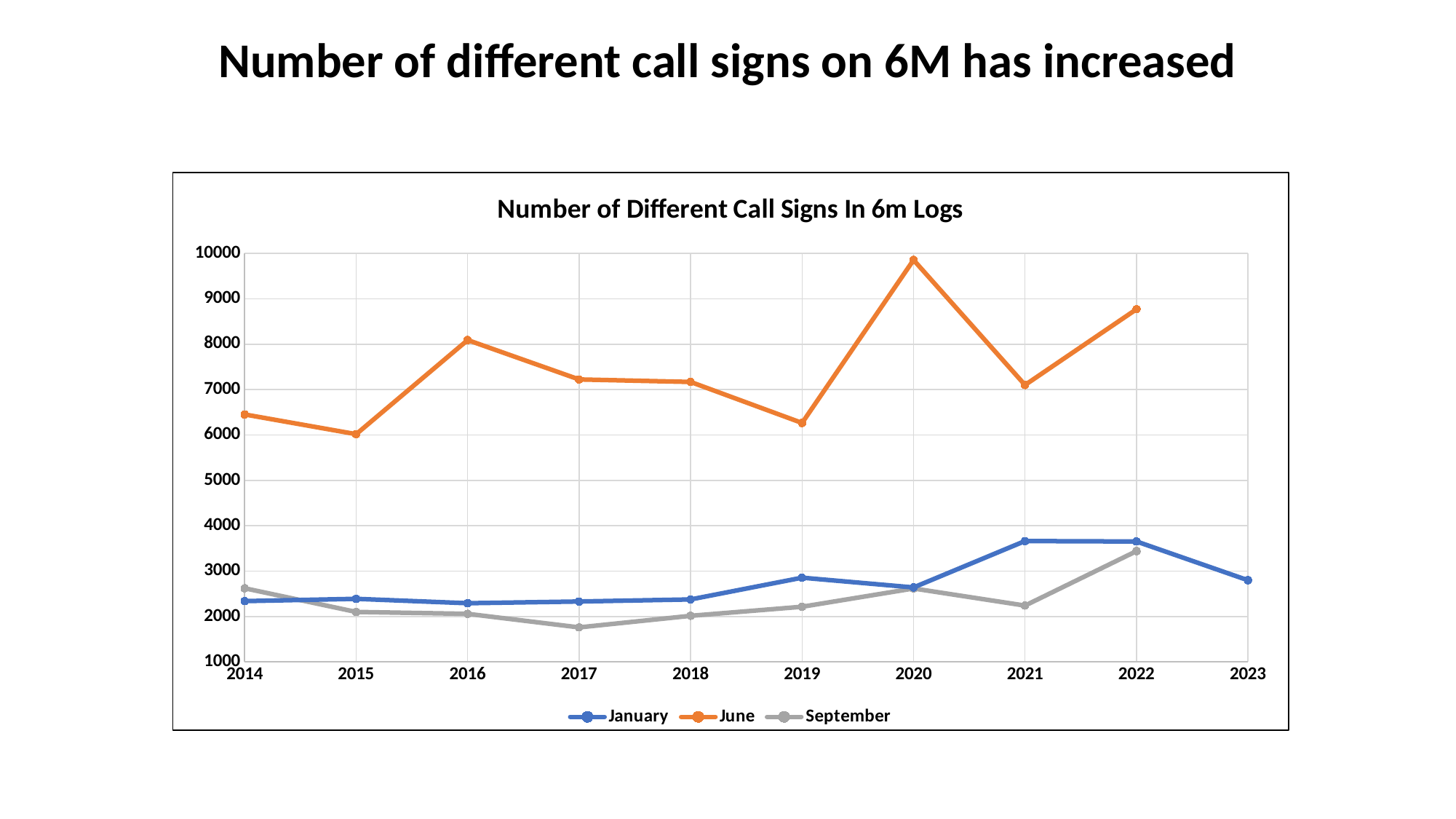
Does the January series rise or fall from 2022 to 2023? fall In which year does the September series reach its lowest value? 2017 What kind of chart is shown on the slide? line chart Which series has the larger value in 2020, June or January? June In which year does the September series reach its highest value? 2022 How many series does the legend list? 3 In which year does the June series reach its highest value? 2020 Is the value for January in 2021 greater or less than 3000? greater How many years are shown on the x axis? 10 What is the title of the chart? Number of Different Call Signs In 6m Logs Is the value for June in 2020 greater or less than 9000? greater Is the value for September in 2017 greater or less than 2000? less